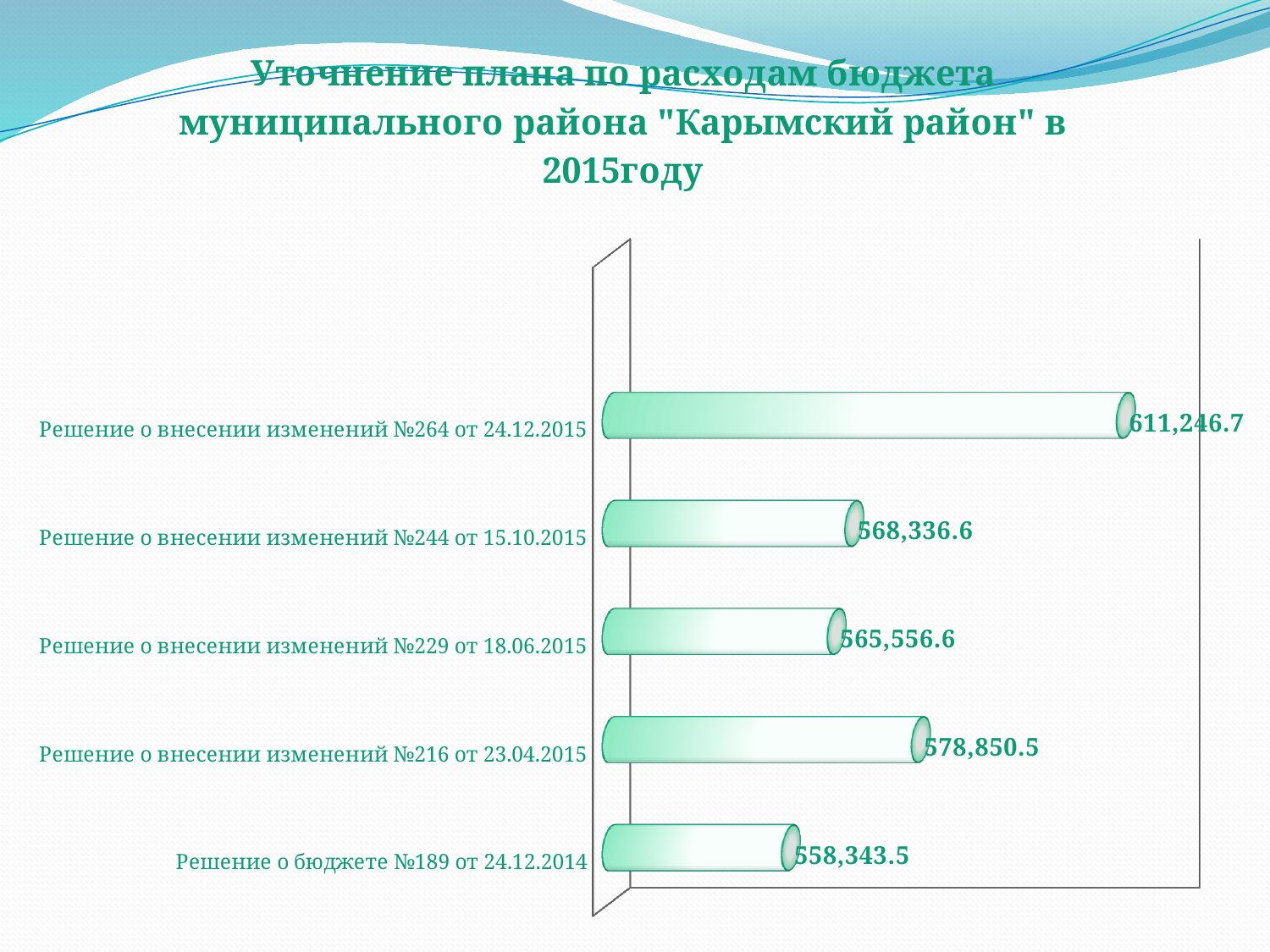
How many categories are shown in the chart? 5 What is the difference between the values for "Решение о внесении изменений №264 от 24.12.2015" and "Решение о бюджете №189 от 24.12.2014"? 52,903.2 What is the value for "Решение о внесении изменений №264 от 24.12.2015"? 611,246.7 Which is larger: the value for "Решение о внесении изменений №216 от 23.04.2015" or for "Решение о внесении изменений №244 от 15.10.2015"? Решение о внесении изменений №216 от 23.04.2015 Which category has the highest value? Решение о внесении изменений №264 от 24.12.2015 What is the title of the slide? Уточнение плана по расходам бюджета муниципального района "Карымский район" в 2015году What is the value for "Решение о бюджете №189 от 24.12.2014"? 558,343.5 What is the difference between the values for "Решение о внесении изменений №216 от 23.04.2015" and "Решение о внесении изменений №229 от 18.06.2015"? 13,293.9 What is the value for "Решение о внесении изменений №216 от 23.04.2015"? 578,850.5 What is the value for "Решение о внесении изменений №229 от 18.06.2015"? 565,556.6 Which category has the lowest value? Решение о бюджете №189 от 24.12.2014 What kind of chart is shown on the slide? Bar chart